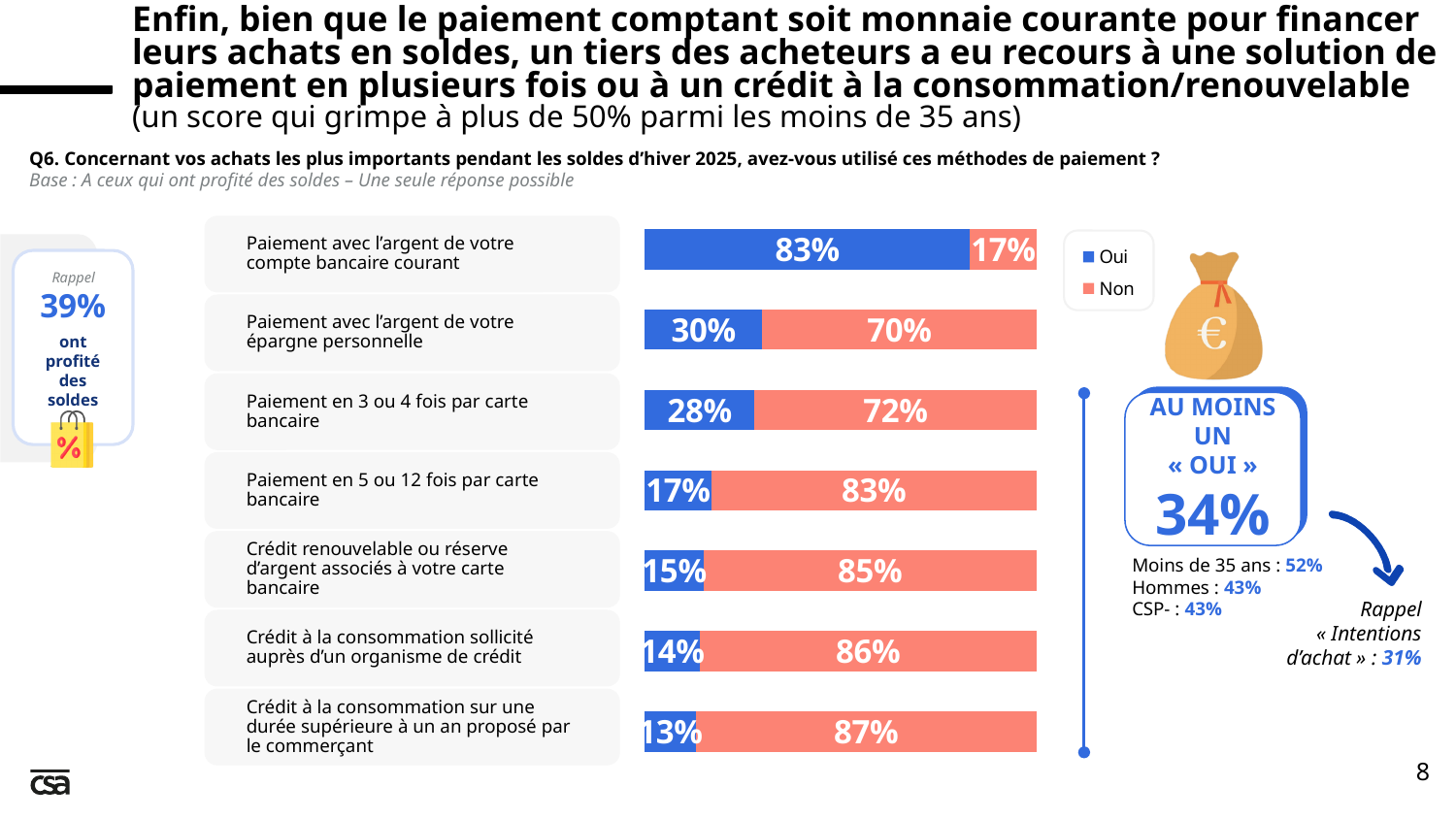
Which payment method has the lowest "Oui" share? Crédit à la consommation sur une durée supérieure à un an proposé par le commerçant What is the total of the "Oui" and "Non" values for "Paiement en 5 ou 12 fois par carte bancaire"? 100% Which colour represents the "Non" series in the chart? Salmon/pink What is the difference between the "Oui" values for "Paiement avec l'argent de votre épargne personnelle" and "Paiement en 5 ou 12 fois par carte bancaire"? 13 percentage points What is the "Non" value for "Paiement avec l'argent de votre épargne personnelle"? 70% Which payment method has the highest "Oui" share? Paiement avec l'argent de votre compte bancaire courant What is the "Oui" value for "Paiement en 3 ou 4 fois par carte bancaire"? 28% What percentage of respondents answered "Oui" for "Paiement avec l'argent de votre compte bancaire courant"? 83% Which has a larger "Oui" value: "Crédit renouvelable ou réserve d'argent associés à votre carte bancaire" or "Crédit à la consommation sollicité auprès d'un organisme de crédit"? Crédit renouvelable ou réserve d'argent associés à votre carte bancaire How many payment methods are shown in the chart? 7 What kind of chart is used to show the payment methods? Stacked bar chart How many series does the legend list? 2